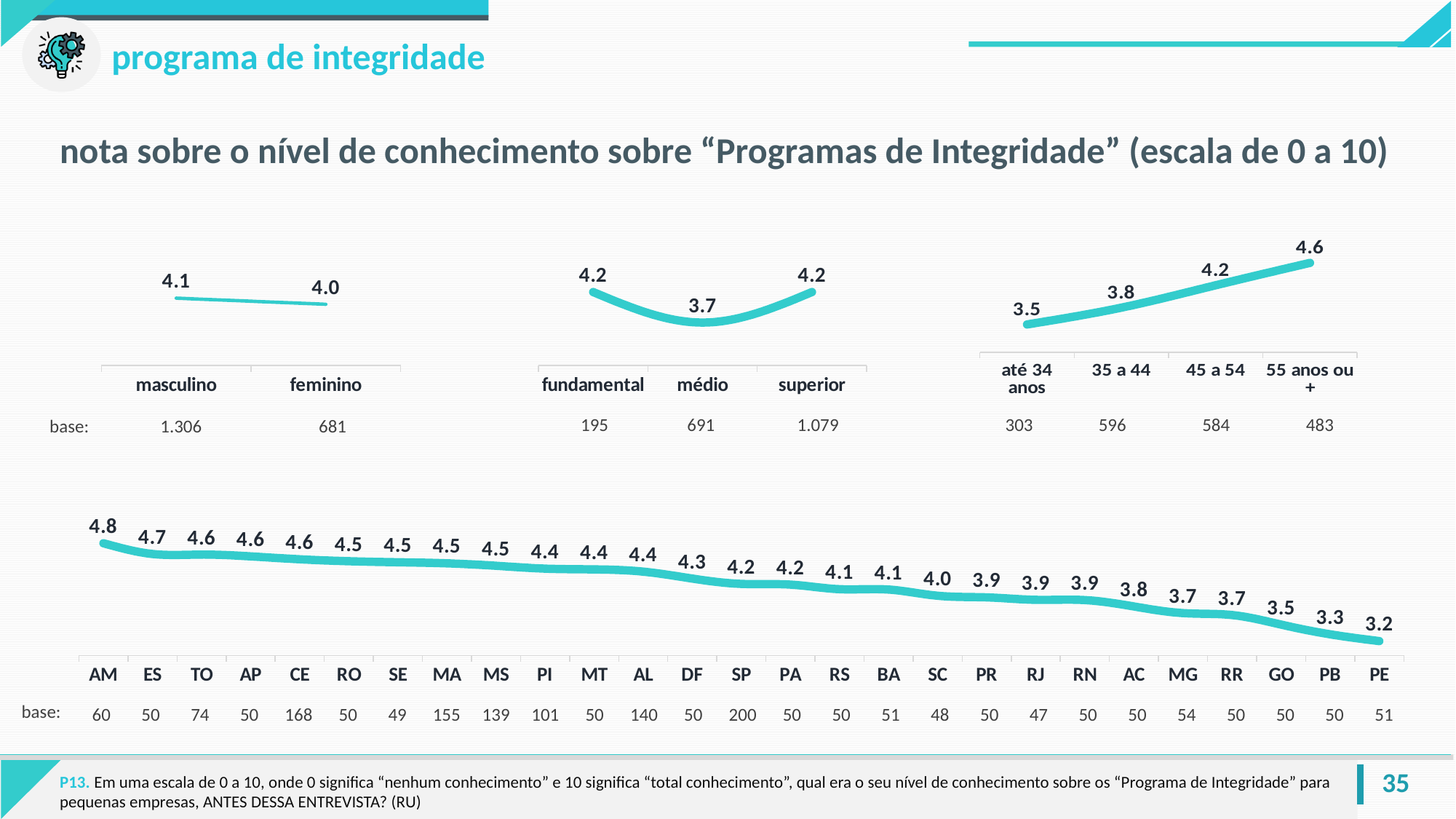
In the age chart (top right), do the values rise or fall from até 34 anos to 55 anos ou +? rise In the age chart (top right), how many age categories are plotted? 4 What kind of chart is the state chart at the bottom of the slide? line chart In the age chart (top right), what is the value for 55 anos ou +? 4.6 In the gender chart (top left), what is the value for masculino? 4.1 In the education chart (top middle), what is the value for superior? 4.2 In the age chart (top right), what is the difference between 55 anos ou + and até 34 anos? 1.1 In the education chart (top middle), which category has the lowest value? médio In the state chart (bottom), what is the value for SP? 4.2 In the gender chart (top left), what is the value for feminino? 4.0 In the state chart (bottom), which state has the highest value? AM In the state chart (bottom), which state has the lowest value? PE